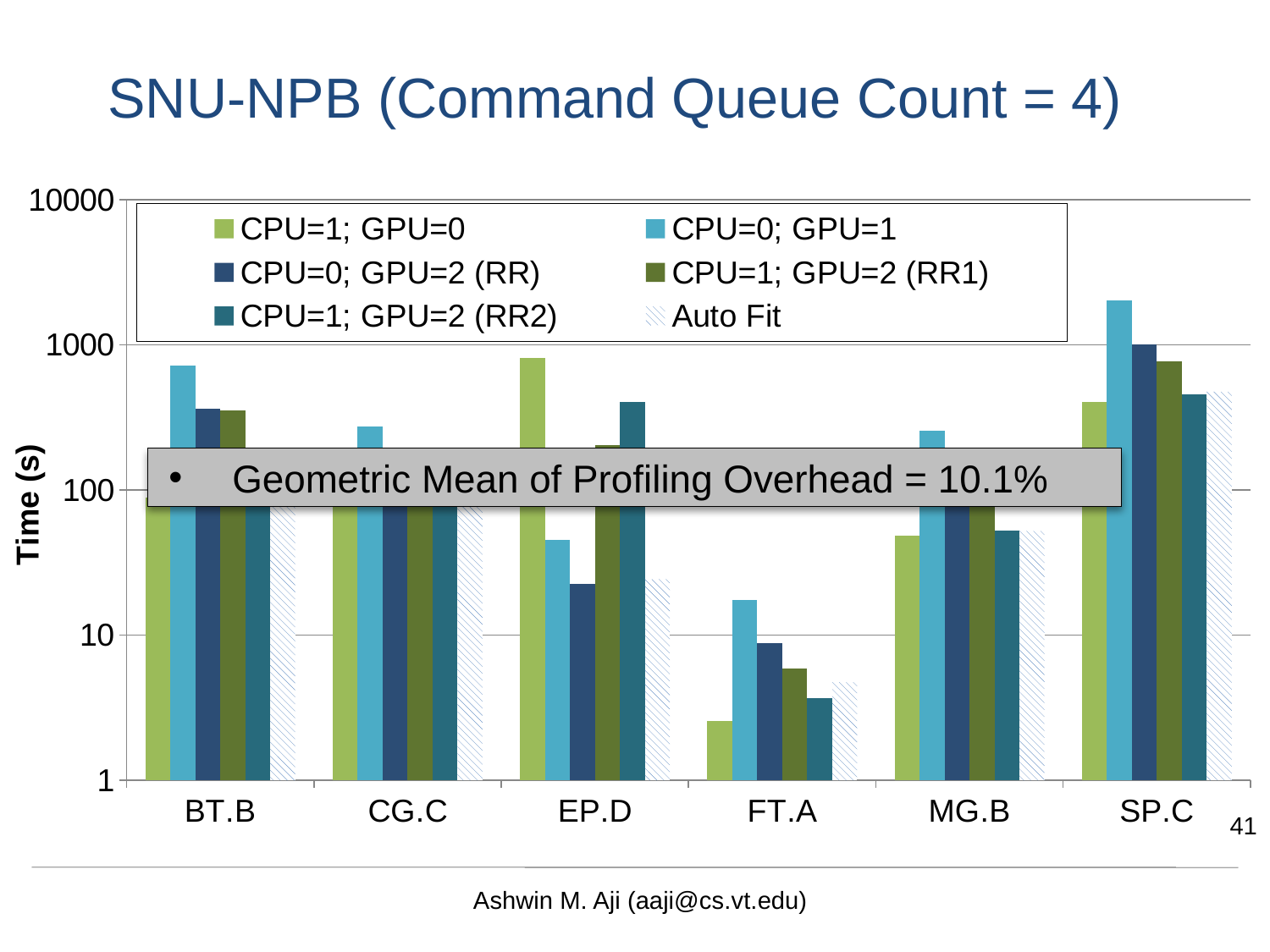
How many benchmark categories are shown on the x axis? 6 Which category has the highest value for the CPU=0; GPU=1 series? SP.C At EP.D, which is larger: the value for CPU=1; GPU=0 or the value for CPU=0; GPU=1? CPU=1; GPU=0 Is the value for CPU=1; GPU=0 at FT.A greater or less than 10? less What is the label of the y axis? Time (s) Is the value for CPU=0; GPU=1 at SP.C greater or less than 1000? greater What kind of chart is shown on the slide? bar chart Is the value for CPU=0; GPU=1 at BT.B greater or less than 100? greater At FT.A, which is larger: the value for CPU=1; GPU=0 or the value for CPU=0; GPU=1? CPU=0; GPU=1 What is the title of the chart? SNU-NPB (Command Queue Count = 4) How many series does the legend list? 6